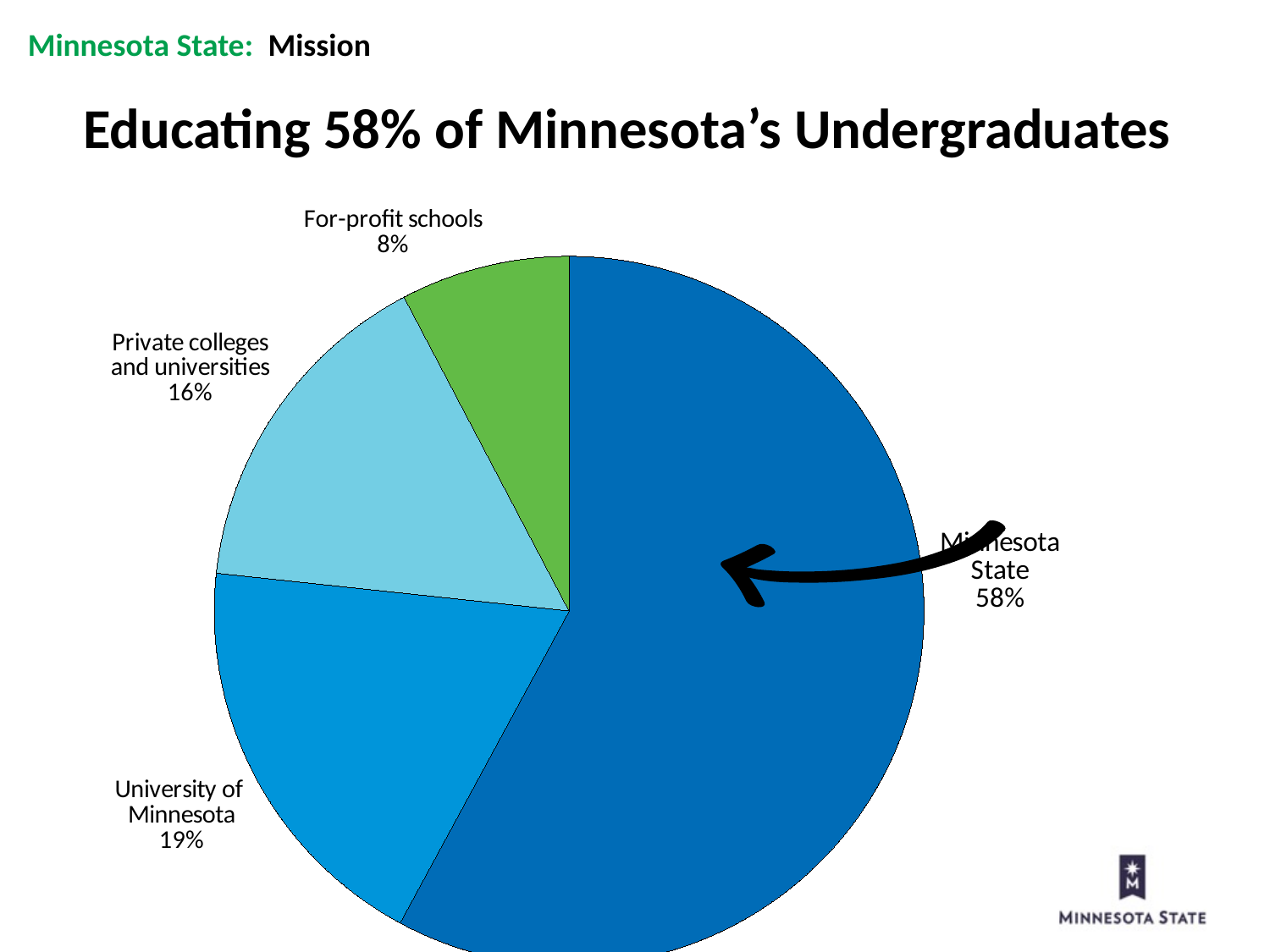
Which category has the largest slice of the pie? Minnesota State What share of Minnesota's undergraduates does Minnesota State educate according to the pie chart? 58% Which category has the smallest slice of the pie? For-profit schools What is the title of the slide above the pie chart? Educating 58% of Minnesota's Undergraduates What percentage is shown for the University of Minnesota? 19% What percentage is shown for for-profit schools? 8% What percentage is shown for private colleges and universities? 16% What is the difference in percentage points between Minnesota State and the University of Minnesota? 39 What is the difference in percentage points between the University of Minnesota and private colleges and universities? 3 Which is larger, the share for the University of Minnesota or the share for for-profit schools? University of Minnesota What kind of chart is shown on the slide? pie chart How many slices does the pie chart have? 4